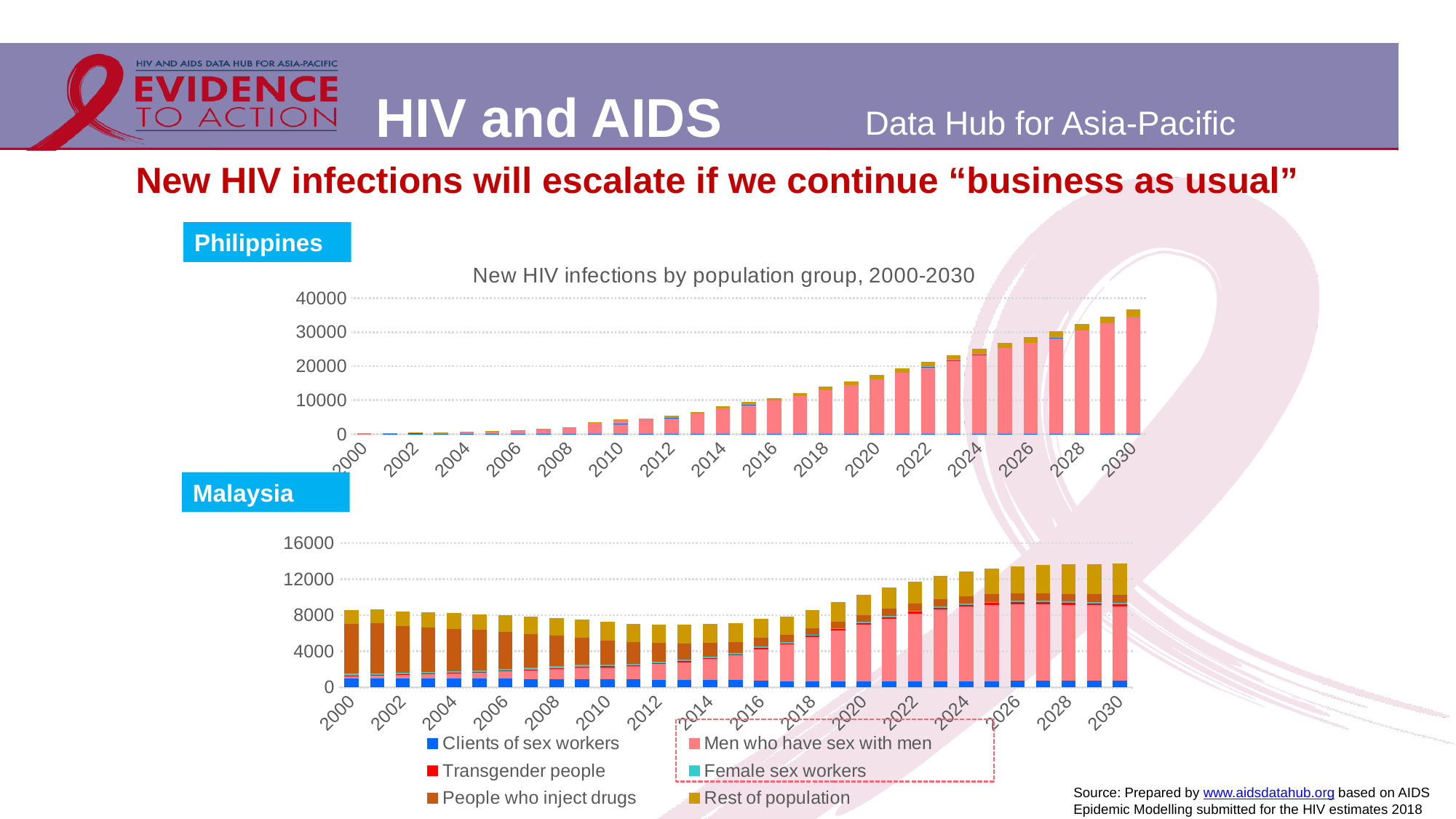
In the Malaysia chart, is the total for 2012 greater or less than 8000? less In the Philippines chart, do the totals rise or fall from 2000 to 2030? rise Which is larger in 2030: the Philippines total or the Malaysia total? Philippines In the Philippines chart, is the total for 2010 greater or less than 10000? less What kind of chart is the Philippines chart? Stacked bar chart What is the title of the Philippines chart? New HIV infections by population group, 2000-2030 How many series does the legend list? 6 In the Philippines chart, is the total for 2020 greater or less than 20000? less How many years (bars) are plotted in the Malaysia chart? 31 In the Philippines chart, which year has the highest total of new HIV infections? 2030